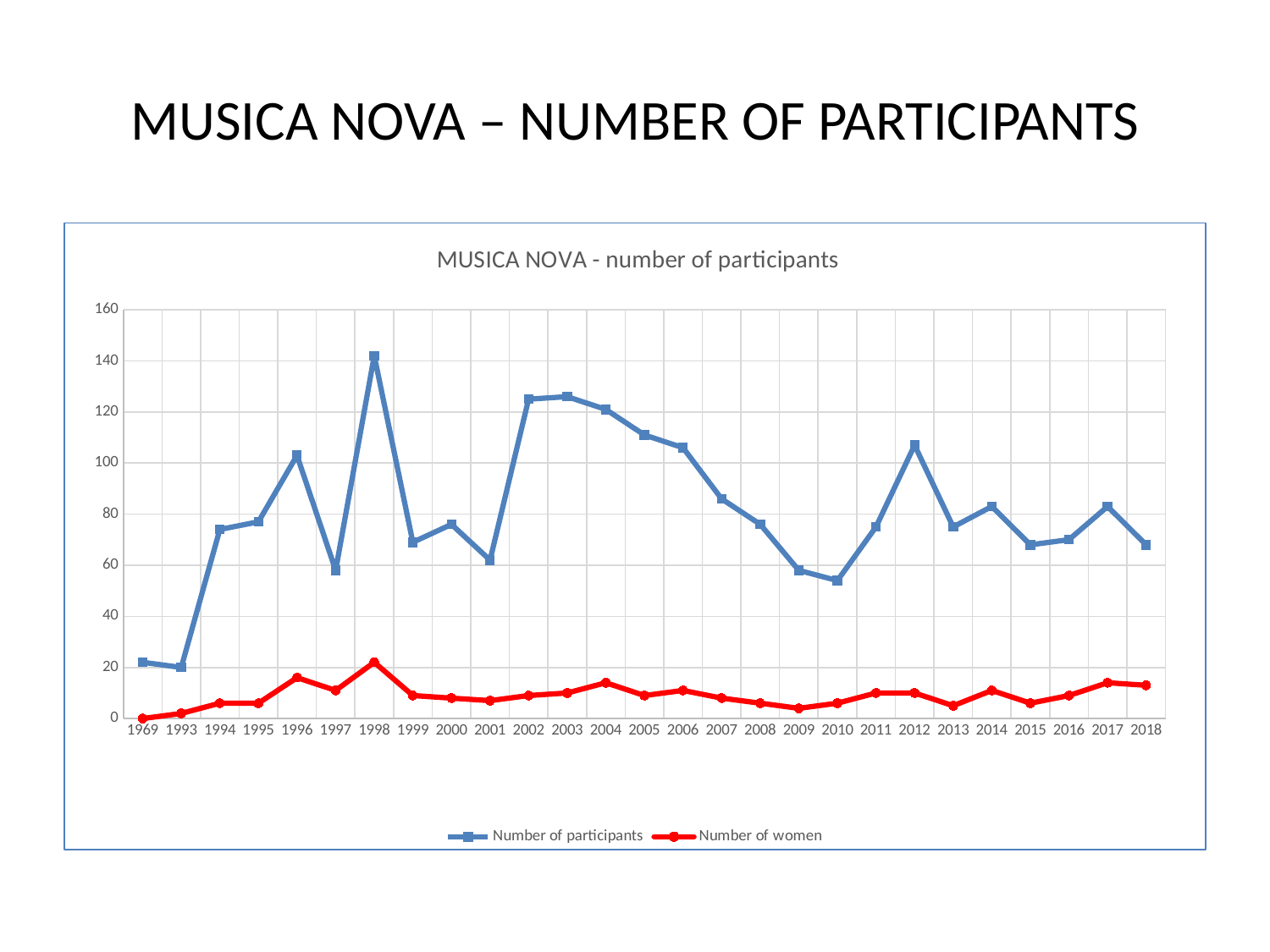
Is the Number of participants in 1998 greater or less than 120? greater What are the two series named in the legend? Number of participants; Number of women How many years are plotted along the x axis? 27 How many series does the legend list? 2 Which year has a larger Number of participants, 2003 or 2012? 2003 In which year is the Number of women lowest? 1969 In which year is the Number of participants highest? 1998 Is the Number of participants in 2002 greater or less than 120? greater Is the Number of participants in 2010 greater or less than 60? less What kind of chart is shown on the slide? line chart In which year is the Number of women highest? 1998 Does the Number of participants rise or fall from 2004 to 2010? fall